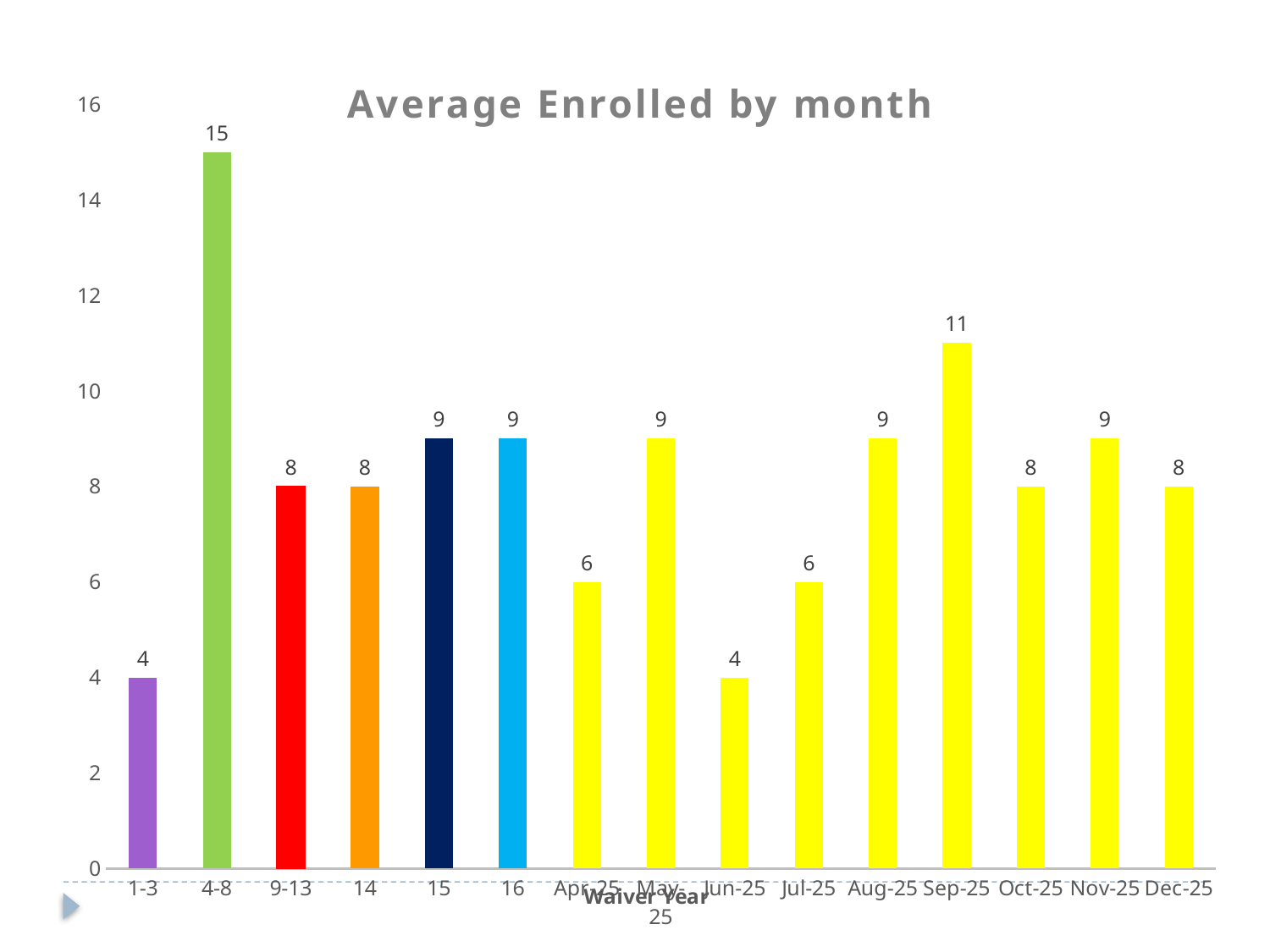
What is the title of the chart? Average Enrolled by month Which is larger, the value for Jul-25 or the value for Aug-25? Aug-25 What is the difference between the values for Sep-25 and Jun-25? 7 What is the value for 4-8? 15 What is the difference between the values for 4-8 and Sep-25? 4 What is the value for Jun-25? 4 Which category has the highest value? 4-8 What is the value for Apr-25? 6 How many categories are shown on the x axis? 15 What kind of chart is shown on the slide? Bar chart What is the value for Sep-25? 11 Which is larger, the value for 1-3 or the value for 9-13? 9-13